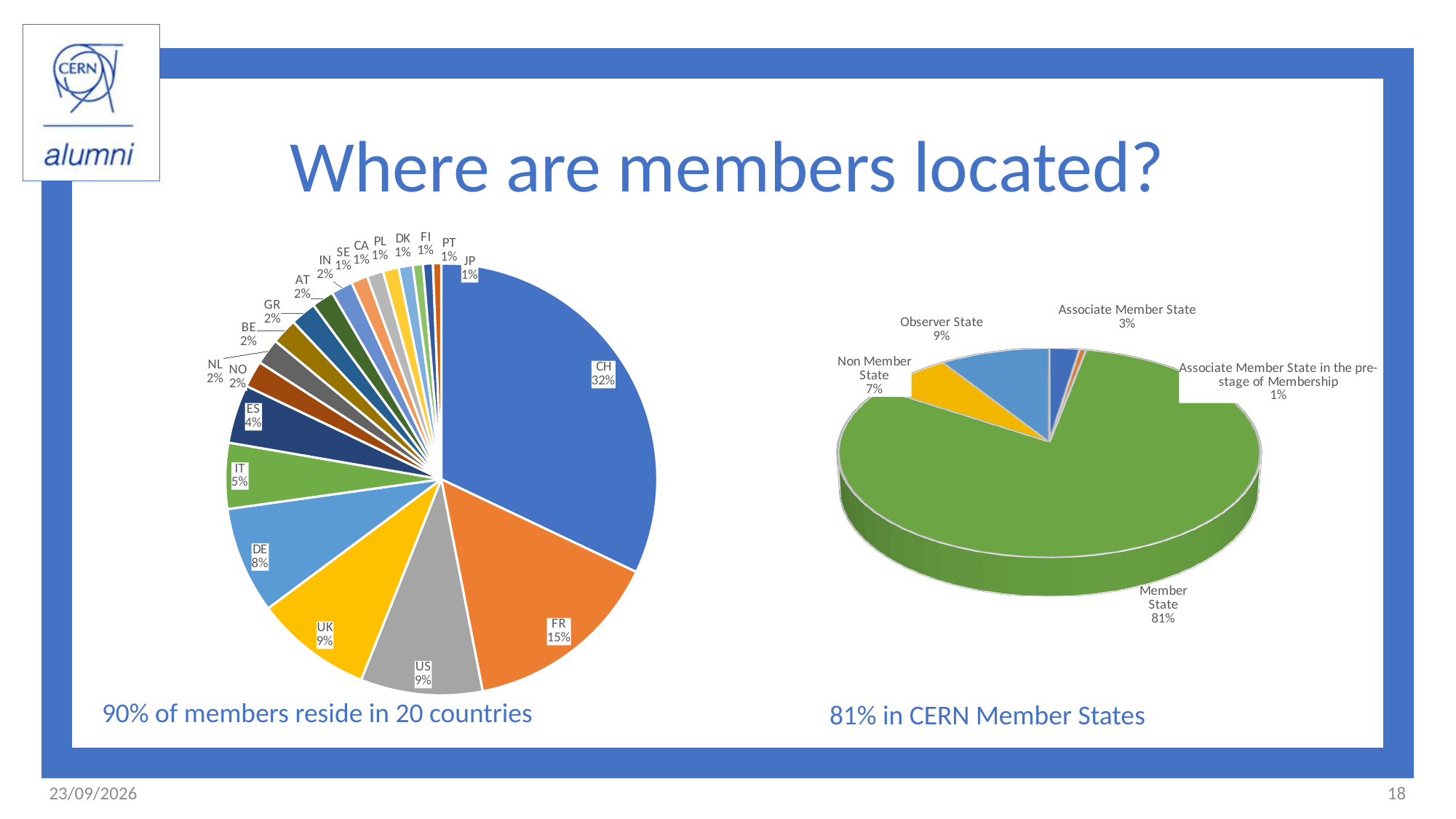
What type of chart is used on the left side of the slide? Pie chart In the left pie chart, what is the difference in percentage points between CH and FR? 17 In the right pie chart, which category has the smallest share? Associate Member State in the pre-stage of Membership In the left pie chart, what share of members is located in CH? 32% In the right pie chart, what is the difference in percentage points between Observer State and Non Member State? 2 In the right pie chart, what share is shown for Member State? 81% In the left pie chart, which country has the largest share of members? CH In the left pie chart, which is larger, the share for DE or the share for IT? DE In the left pie chart, how many countries are labelled? 20 In the right pie chart, how many categories are shown? 5 In the left pie chart, what percentage is shown for FR? 15% In the right pie chart, what percentage is shown for Observer State? 9%